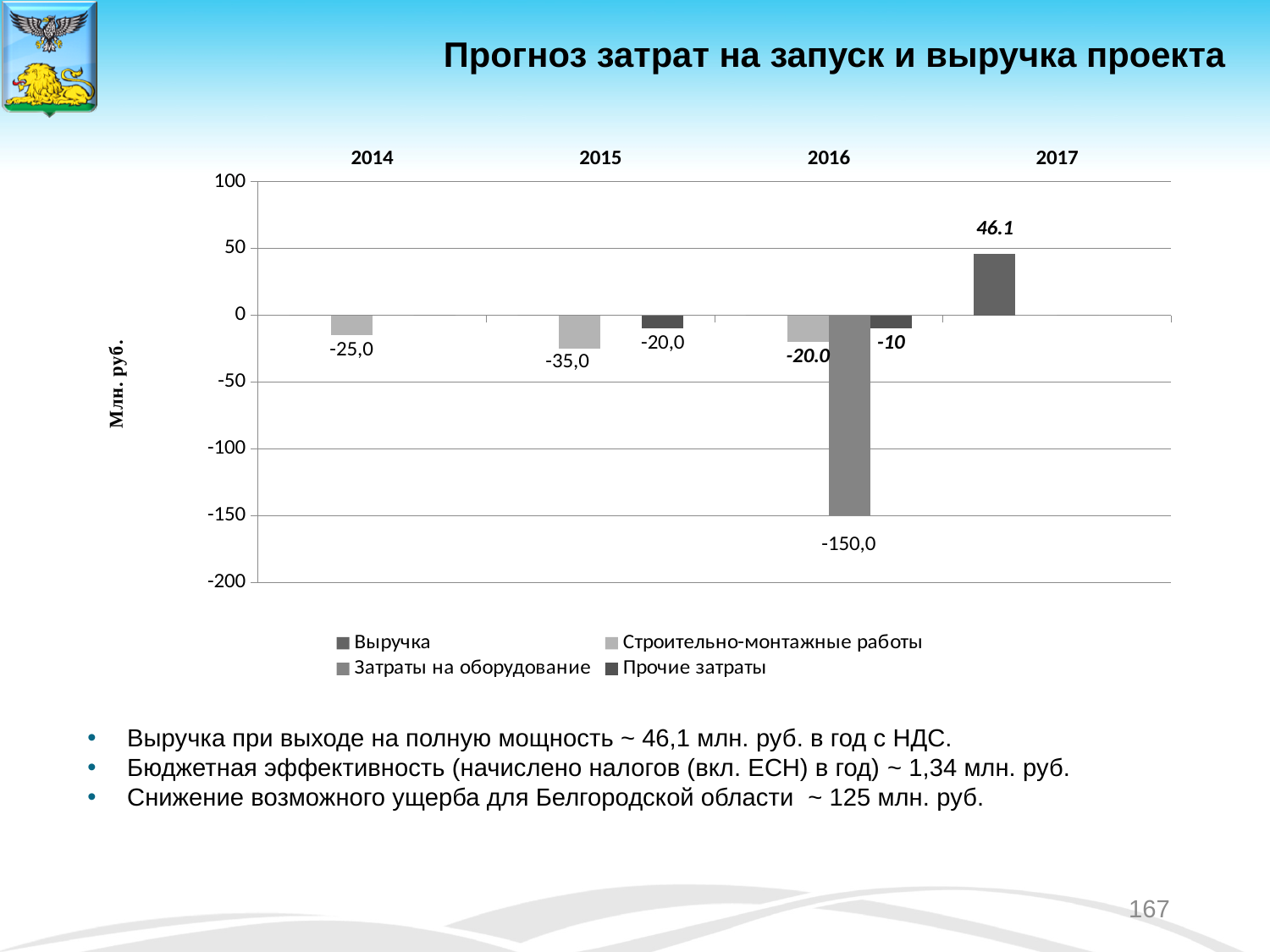
What is the value of Затраты на оборудование in 2016? -150,0 What is the title of the chart on the slide? Прогноз затрат на запуск и выручка проекта What is the value of Строительно-монтажные работы in 2014? -25,0 How many series does the legend list? 4 What is the difference between the Строительно-монтажные работы values for 2015 and 2014? 10 What is the value of Прочие затраты in 2016? -10 Which is larger in absolute value: Прочие затраты in 2015 or Прочие затраты in 2016? 2015 What is the value of Строительно-монтажные работы in 2015? -35,0 Which year has the lowest (most negative) bar in the chart? 2016 How many years are shown on the x axis of the chart? 4 What is the value of Выручка in 2017? 46.1 What type of chart is shown on the slide? bar chart